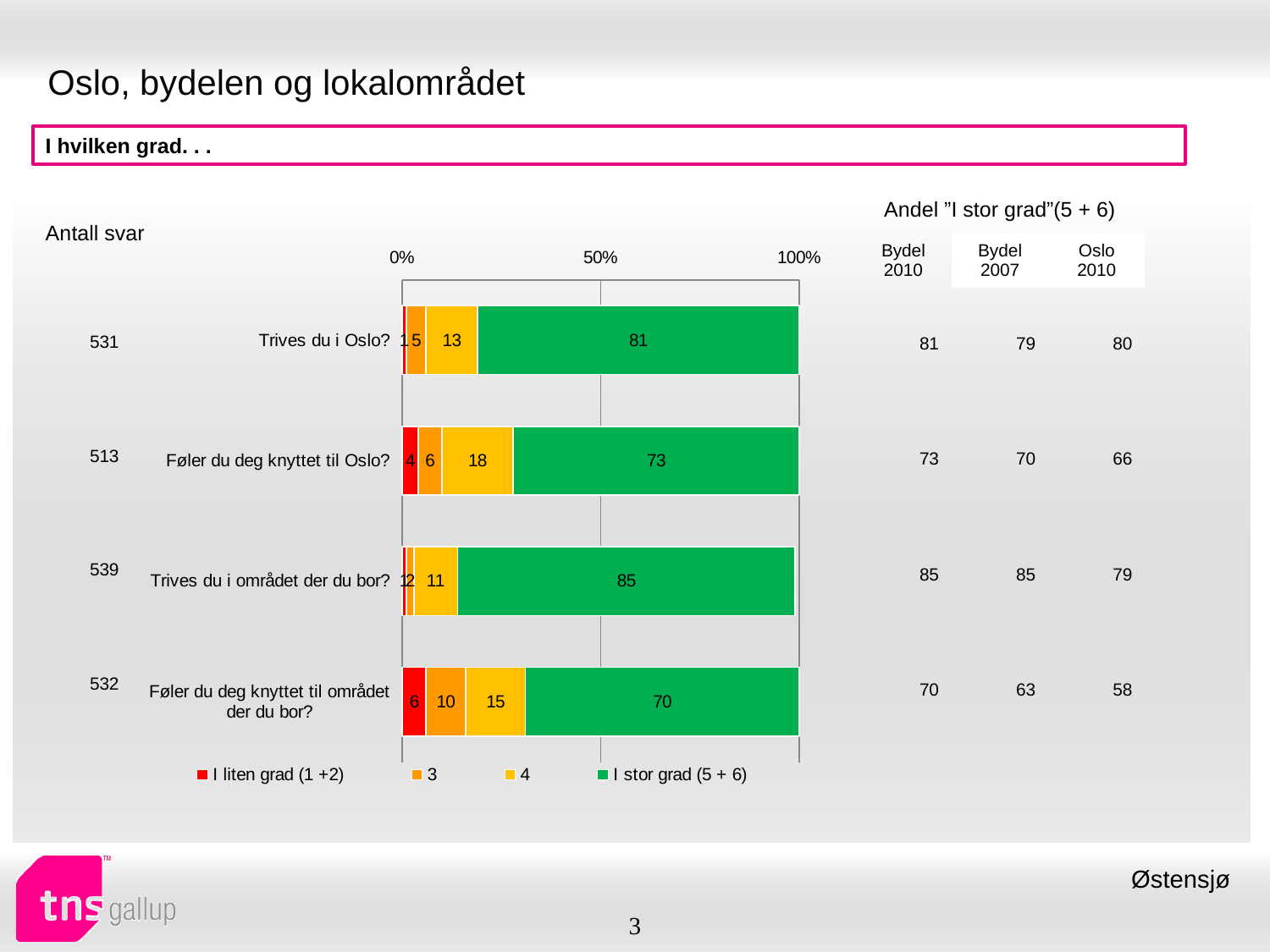
How many series does the legend list? 4 What is the value of series '3' for 'Føler du deg knyttet til Oslo?'? 6 Which is larger: the 'I liten grad (1 +2)' value for 'Føler du deg knyttet til området der du bor?' or for 'Føler du deg knyttet til Oslo?'? Føler du deg knyttet til området der du bor? What is the 'I stor grad (5 + 6)' value for 'Føler du deg knyttet til Oslo?'? 73 Which question has the lowest 'I stor grad (5 + 6)' value? Føler du deg knyttet til området der du bor? Which question has the highest 'I stor grad (5 + 6)' value? Trives du i området der du bor? How many questions (categories) are plotted in the chart? 4 What is the 'Antall svar' shown for 'Trives du i området der du bor?'? 539 What kind of chart is shown on the slide? stacked bar chart What is the value of series '4' for 'Føler du deg knyttet til området der du bor?'? 15 What is the 'I stor grad (5 + 6)' value for 'Trives du i Oslo?'? 81 What is the difference between the 'I stor grad (5 + 6)' values for 'Trives du i området der du bor?' and 'Føler du deg knyttet til området der du bor?'? 15